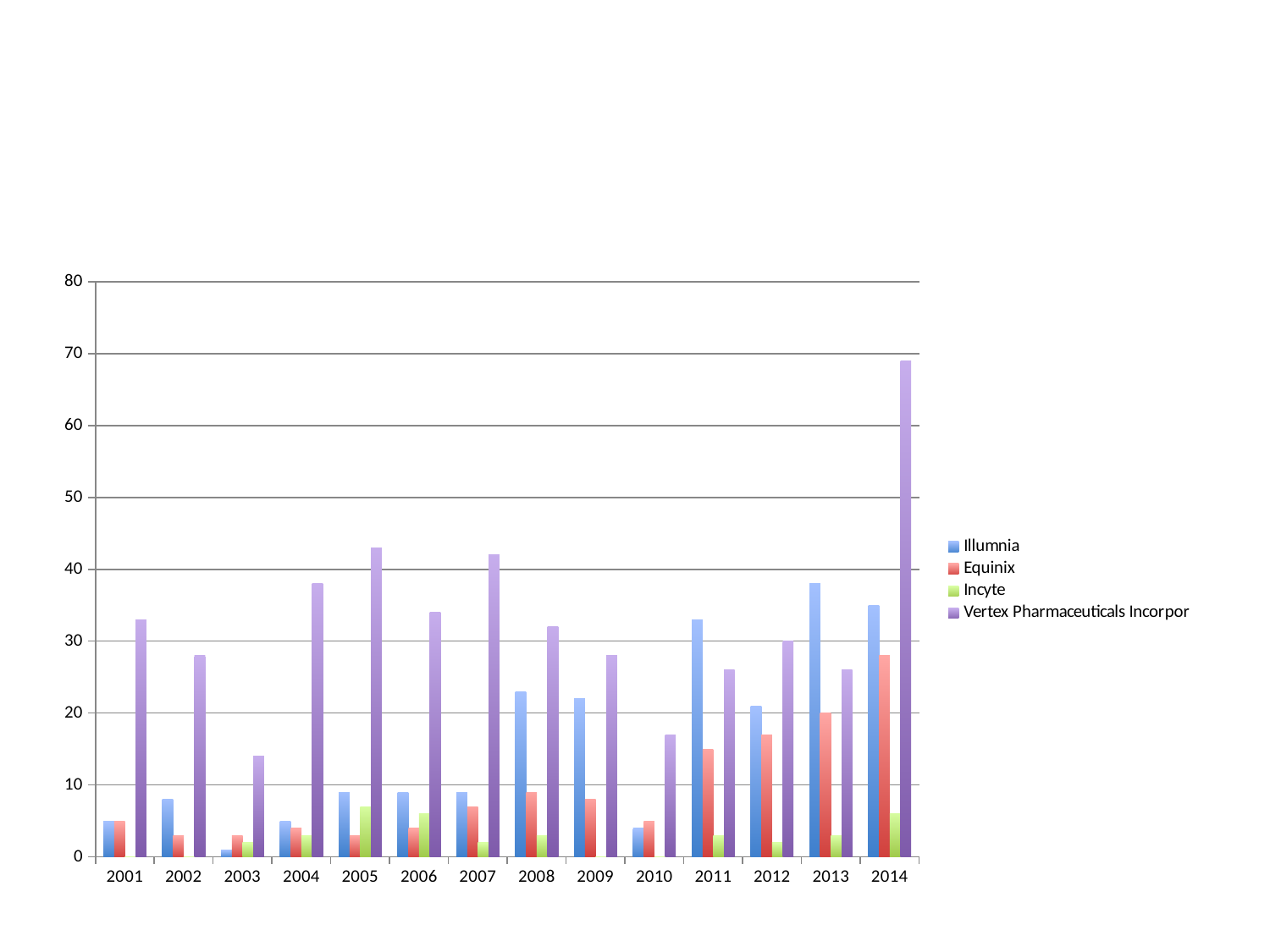
In 2014, which is larger, Illumnia or Vertex Pharmaceuticals Incorpor? Vertex Pharmaceuticals Incorpor In which year is the Vertex Pharmaceuticals Incorpor value highest? 2014 How many years are shown on the x axis? 14 How many series does the legend list? 4 In 2011, which is larger, Illumnia or Equinix? Illumnia Is the value for Equinix in 2012 greater or less than 20? less Is the value for Illumnia in 2013 greater or less than 30? greater In which year is the Vertex Pharmaceuticals Incorpor value lowest? 2003 Is the value for Vertex Pharmaceuticals Incorpor in 2014 greater or less than 60? greater What kind of chart is shown on the slide? bar chart Do the Equinix values rise or fall from 2010 to 2014? rise What colour represents Incyte in the legend? green